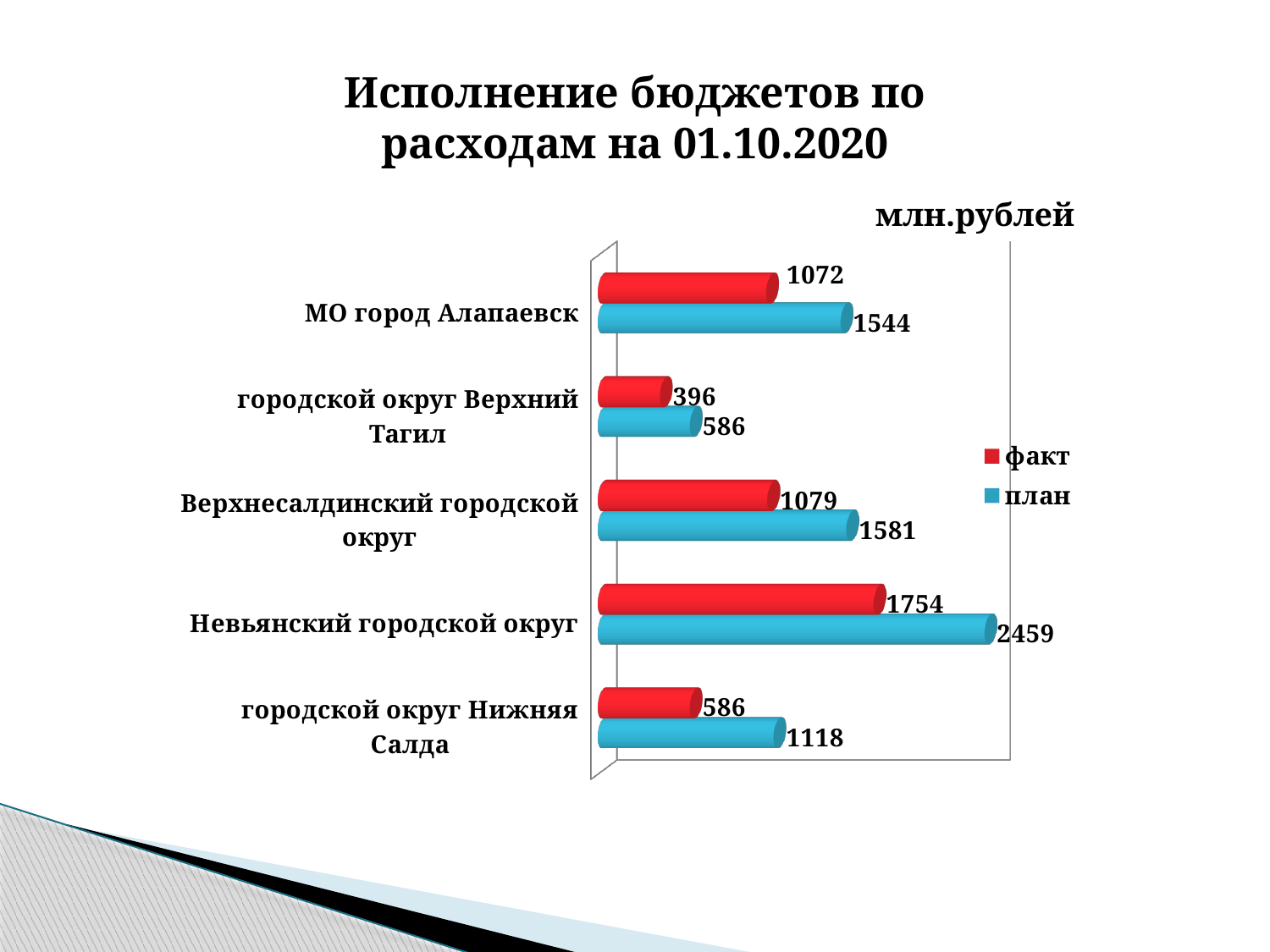
What is the факт value for Невьянский городской округ? 1754 How many categories are shown in the chart? 5 Which category has the lowest факт value? городской округ Верхний Тагил What is the difference between план and факт for городской округ Нижняя Салда? 532 How many series does the legend list? 2 What is the план value for МО город Алапаевск? 1544 Which category has the highest план value? Невьянский городской округ What kind of chart is shown on the slide? bar chart What unit is indicated above the chart? млн.рублей What is the план value for городской округ Верхний Тагил? 586 Which is larger: the факт value for МО город Алапаевск or the факт value for Верхнесалдинский городской округ? Верхнесалдинский городской округ What is the difference between план and факт for Невьянский городской округ? 705